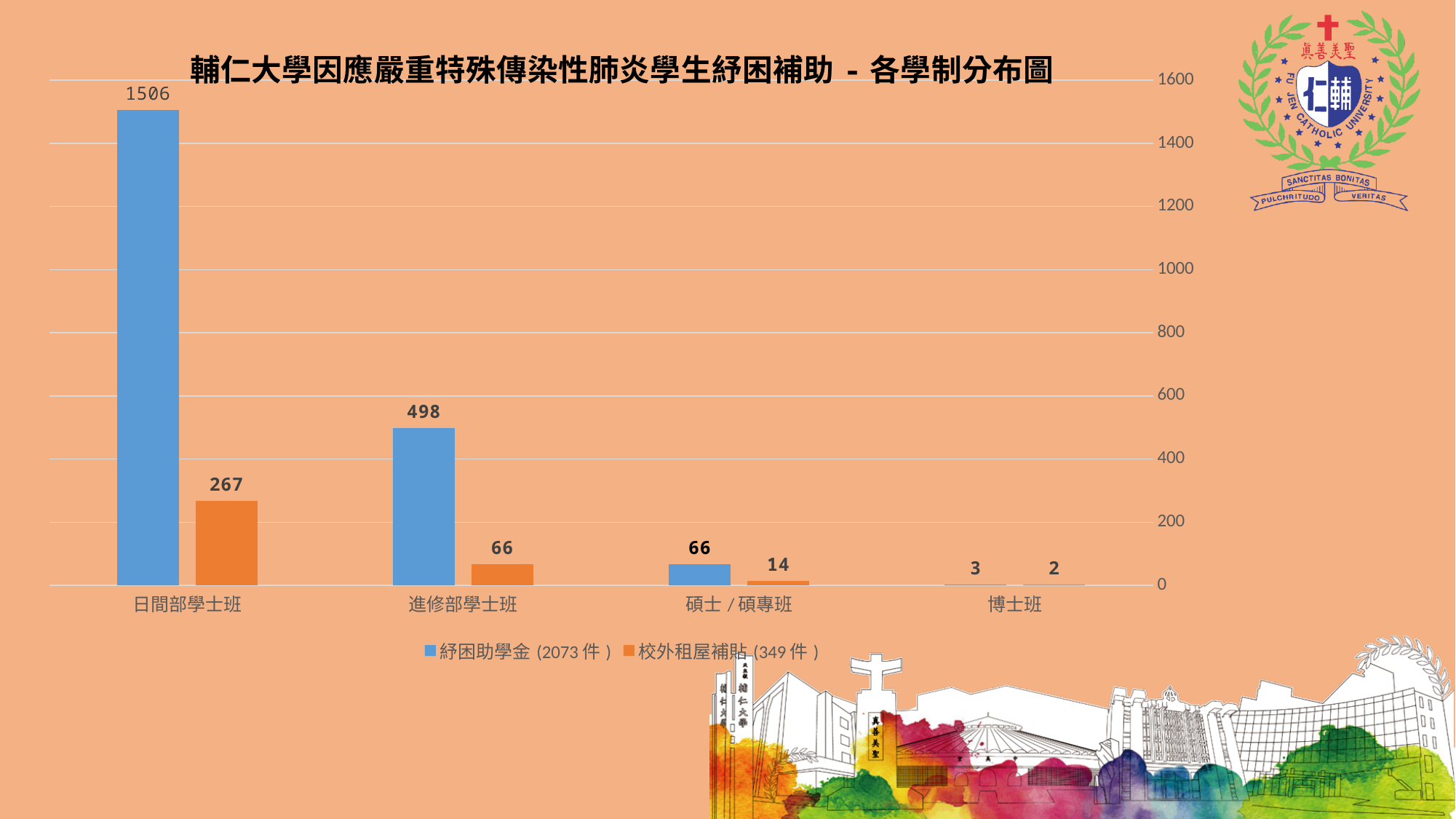
How many categories are shown on the x axis? 4 What colour are the 校外租屋補貼 bars? orange Which category has the lowest 校外租屋補貼 value? 博士班 What kind of chart is shown on the slide? bar chart Which is larger for 碩士／碩專班: 紓困助學金 or 校外租屋補貼? 紓困助學金 What is the value of 校外租屋補貼 for 進修部學士班? 66 What is the difference between 紓困助學金 and 校外租屋補貼 for 日間部學士班? 1239 What is the value of 校外租屋補貼 for 博士班? 2 Is the 紓困助學金 value for 進修部學士班 greater or less than 400? greater How many series does the legend list? 2 Which category has the highest 紓困助學金 value? 日間部學士班 What is the value of 紓困助學金 for 日間部學士班? 1506